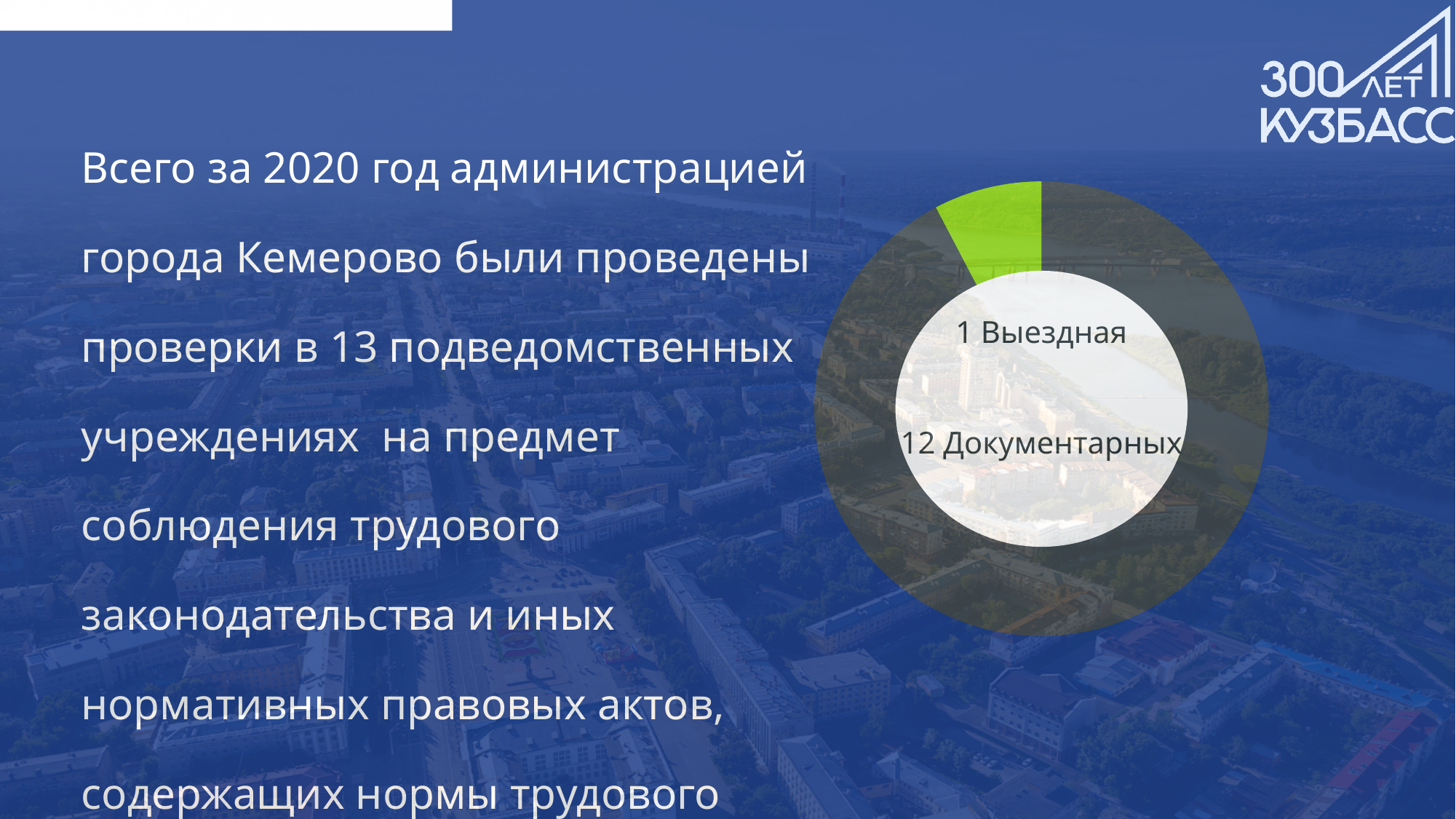
How many inspections are labelled as Выездная (on-site) in the chart? 1 Which category has the larger slice in the chart? Документарных What colour is the slice for Выездная in the chart? green What kind of chart is shown on the slide? doughnut (pie) chart Which is larger: the number of Выездная inspections or the number of Документарных inspections? Документарных What is the difference between the number of Документарных and Выездная inspections? 11 What is the total number of inspections shown in the chart? 13 Is the number of Документарных inspections greater or less than 10? greater Which category has the smaller slice in the chart? Выездная How many inspections are labelled as Документарных (documentary) in the chart? 12 How many slices does the doughnut chart have? 2